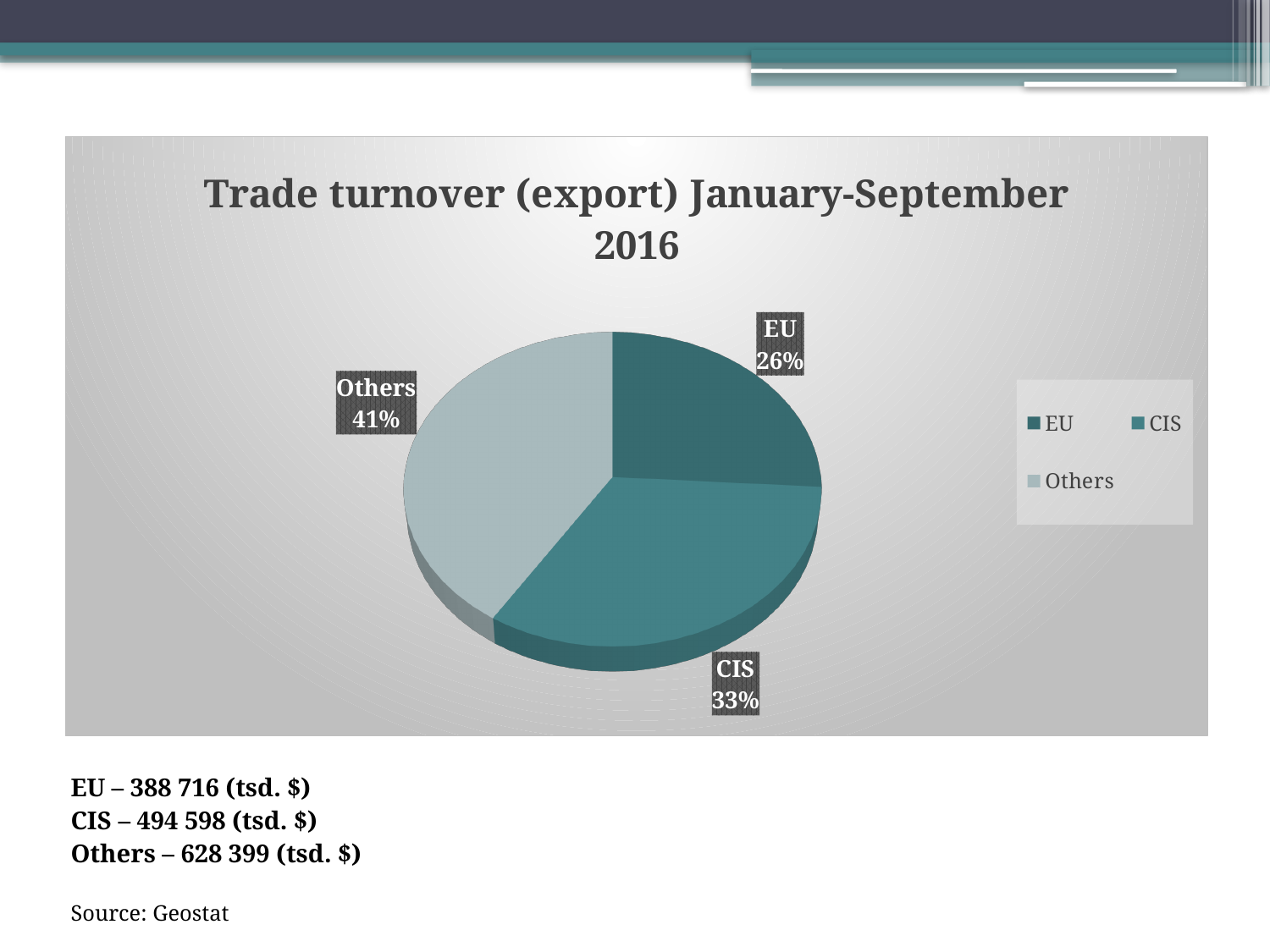
What is the difference in percentage points between the Others share and the EU share? 15 percentage points What share of the pie does the CIS slice represent? 33% Which category has the largest share of the pie? Others What kind of chart is shown on the slide? pie chart How many entries does the legend list? 3 How many slices does the pie chart have? 3 What share of the pie does the Others slice represent? 41% What is the title of the chart? Trade turnover (export) January-September 2016 Which category has the smallest share of the pie? EU What share of the pie does the EU slice represent? 26% Is the share for Others greater or less than 50%? less Which slice is larger, CIS or EU? CIS